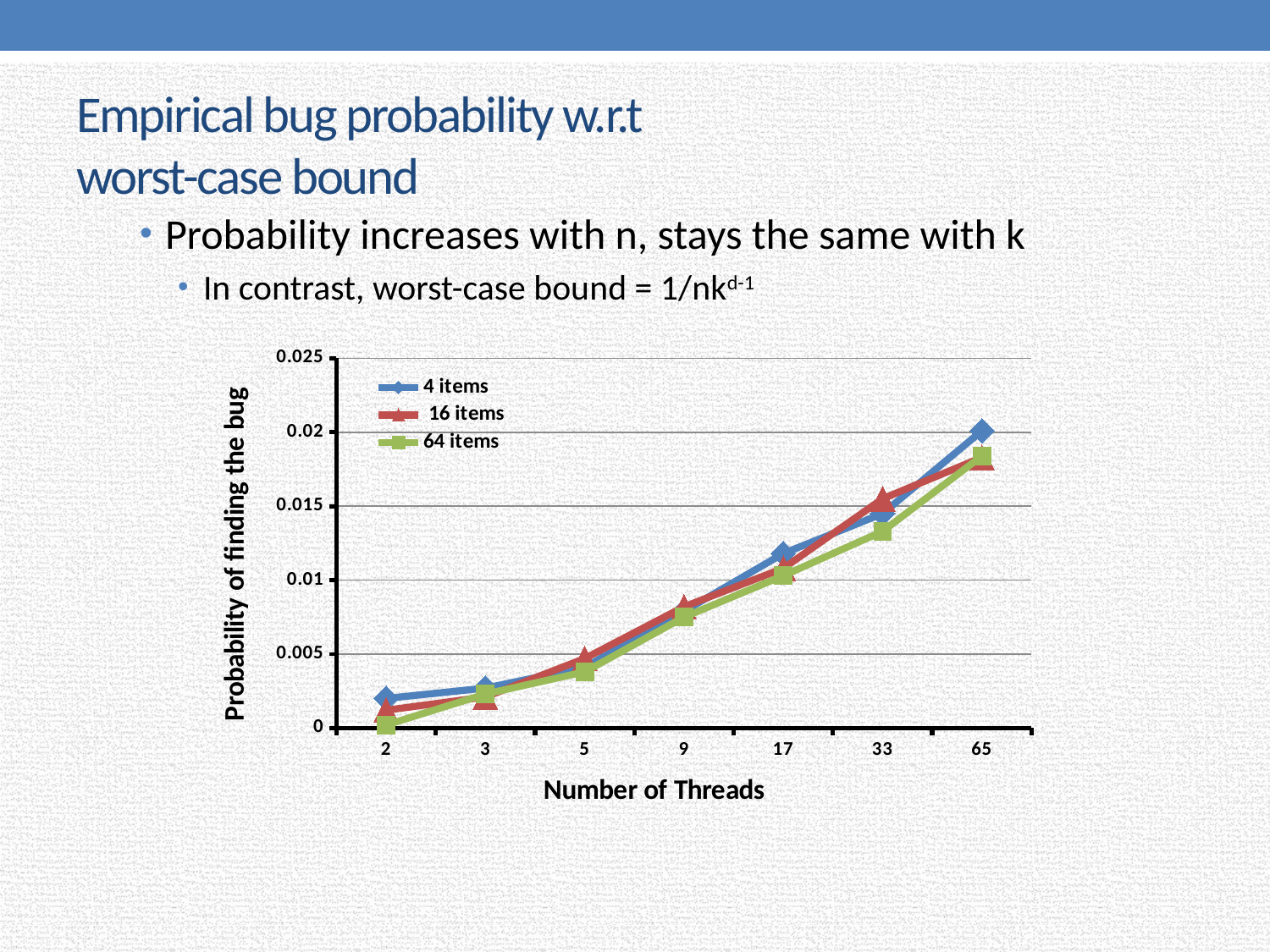
Is the value for 64 items at 2 threads greater or less than 0.005? less At which number of threads is the 4 items series highest? 65 At 2 threads, which series has the larger value, 4 items or 64 items? 4 items What is the title of the y axis? Probability of finding the bug At 33 threads, which series has the larger value, 16 items or 64 items? 16 items Is the value for 4 items at 17 threads greater or less than 0.01? greater How many thread counts are plotted along the x axis? 7 At which number of threads is the 64 items series lowest? 2 Do the values for the 4 items series rise or fall as the number of threads increases? rise Is the value for 16 items at 9 threads greater or less than 0.01? less What kind of chart is shown on the slide? line chart How many series does the legend list? 3